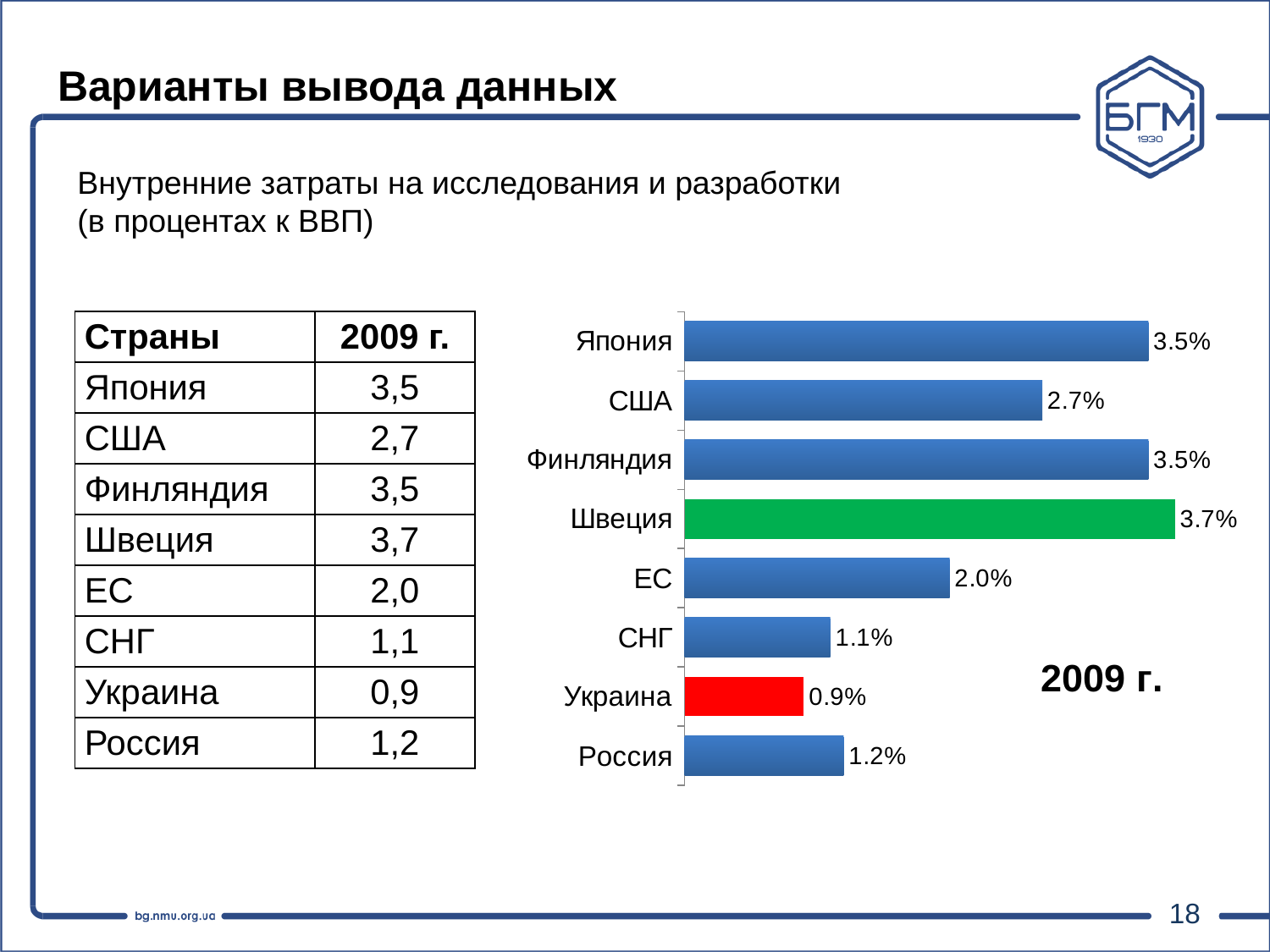
What is the difference between the values for США and ЕС? 0.7% Which has a larger value, Россия or СНГ? Россия How many categories are shown in the chart? 8 Which category's bar is coloured red in the chart? Украина What type of chart is shown on the slide? bar chart What is the difference between the values for Швеция and Украина? 2.8% What is the value for ЕС in the chart? 2.0% Which category has the highest value in the chart? Швеция What is the value for США in the chart? 2.7% What is the value for Украина in the chart? 0.9% Which category has the lowest value in the chart? Украина What is the value for Швеция in the chart? 3.7%